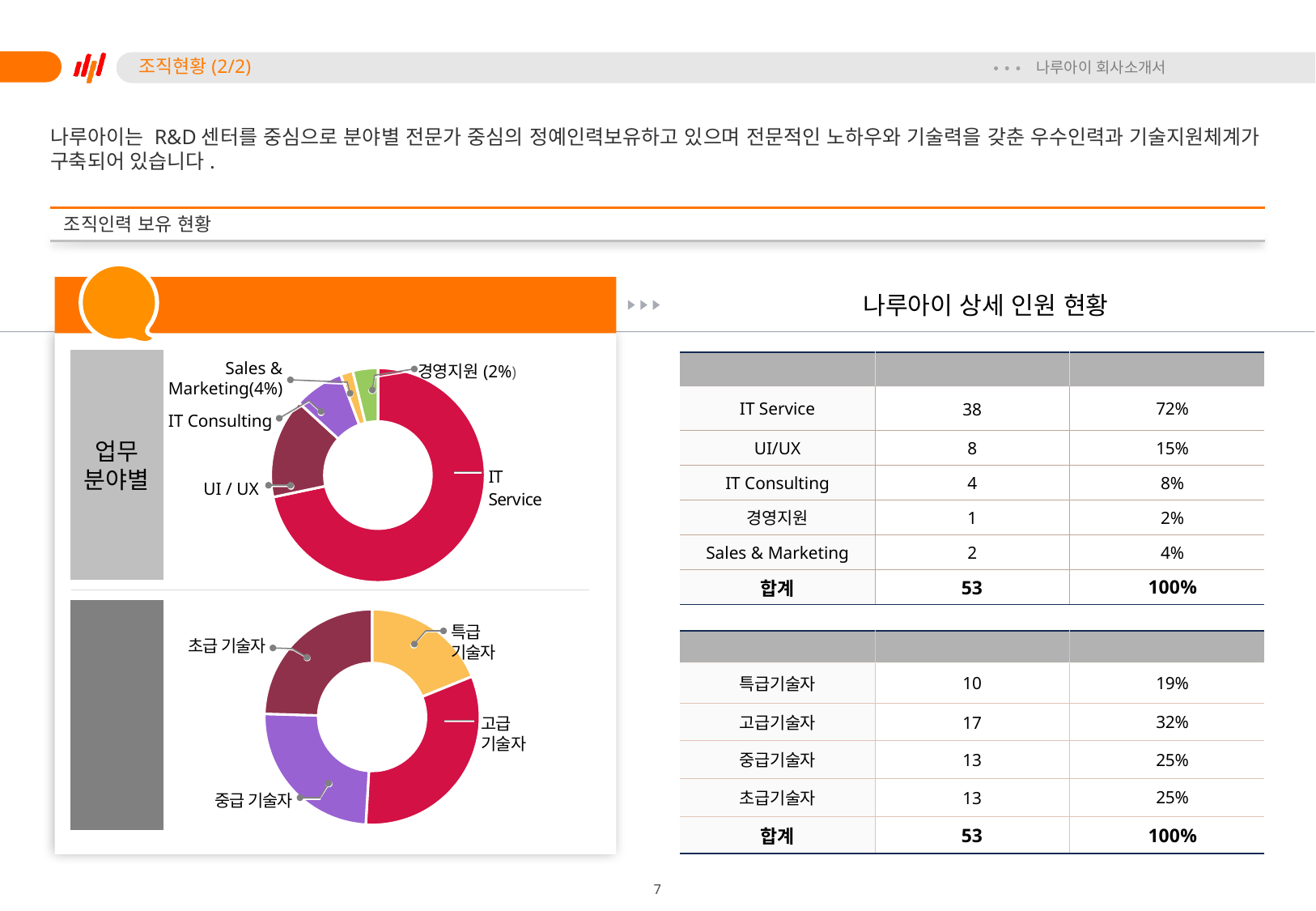
In the top chart (업무 분야별), which category has the largest slice? IT Service In the top chart (업무 분야별), which slice is larger: UI / UX or IT Consulting? UI / UX In the top chart (업무 분야별), what is the difference in percentage points between Sales & Marketing and 경영지원? 2 percentage points What type of chart is used in the top chart (업무 분야별) on the left of the slide? Pie chart (donut) How many categories are shown in the top chart (업무 분야별)? 5 How many categories are shown in the bottom chart on the left of the slide? 4 In the top chart (업무 분야별), what share is shown for 경영지원? 2% In the bottom chart on the left of the slide, which slice is larger: 고급 기술자 or 특급 기술자? 고급 기술자 In the bottom chart on the left of the slide, which category has the largest slice? 고급 기술자 In the top chart (업무 분야별), what share is shown for Sales & Marketing? 4% In the bottom chart on the left of the slide, which category has the smallest slice? 특급 기술자